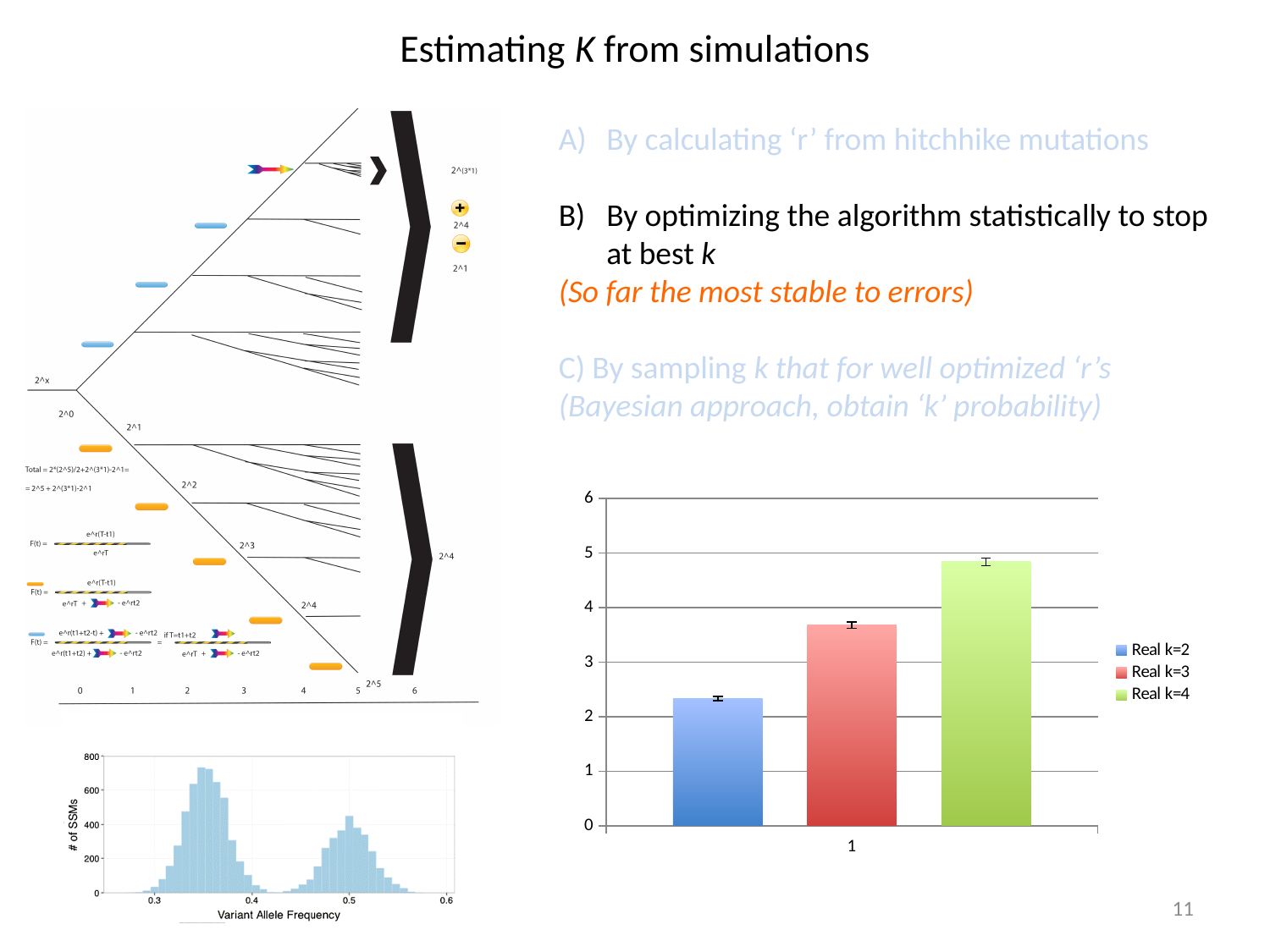
In the bar chart on the right, is the bar for Real k=3 greater or less than 4? less In the histogram at the bottom left, what is the label of the x axis? Variant Allele Frequency In the bar chart on the right, what kind of chart is shown? bar chart In the bar chart on the right, is the bar for Real k=3 greater or less than 3? greater In the bar chart on the right, which series has the lowest bar? Real k=2 In the bar chart on the right, how many series does the legend list? 3 In the bar chart on the right, how many categories are shown on the x axis? 1 In the bar chart on the right, which is larger, the bar for Real k=2 or the bar for Real k=3? Real k=3 In the bar chart on the right, what colour is the bar for Real k=3? red In the bar chart on the right, is the bar for Real k=2 greater or less than 3? less In the bar chart on the right, which series has the highest bar? Real k=4